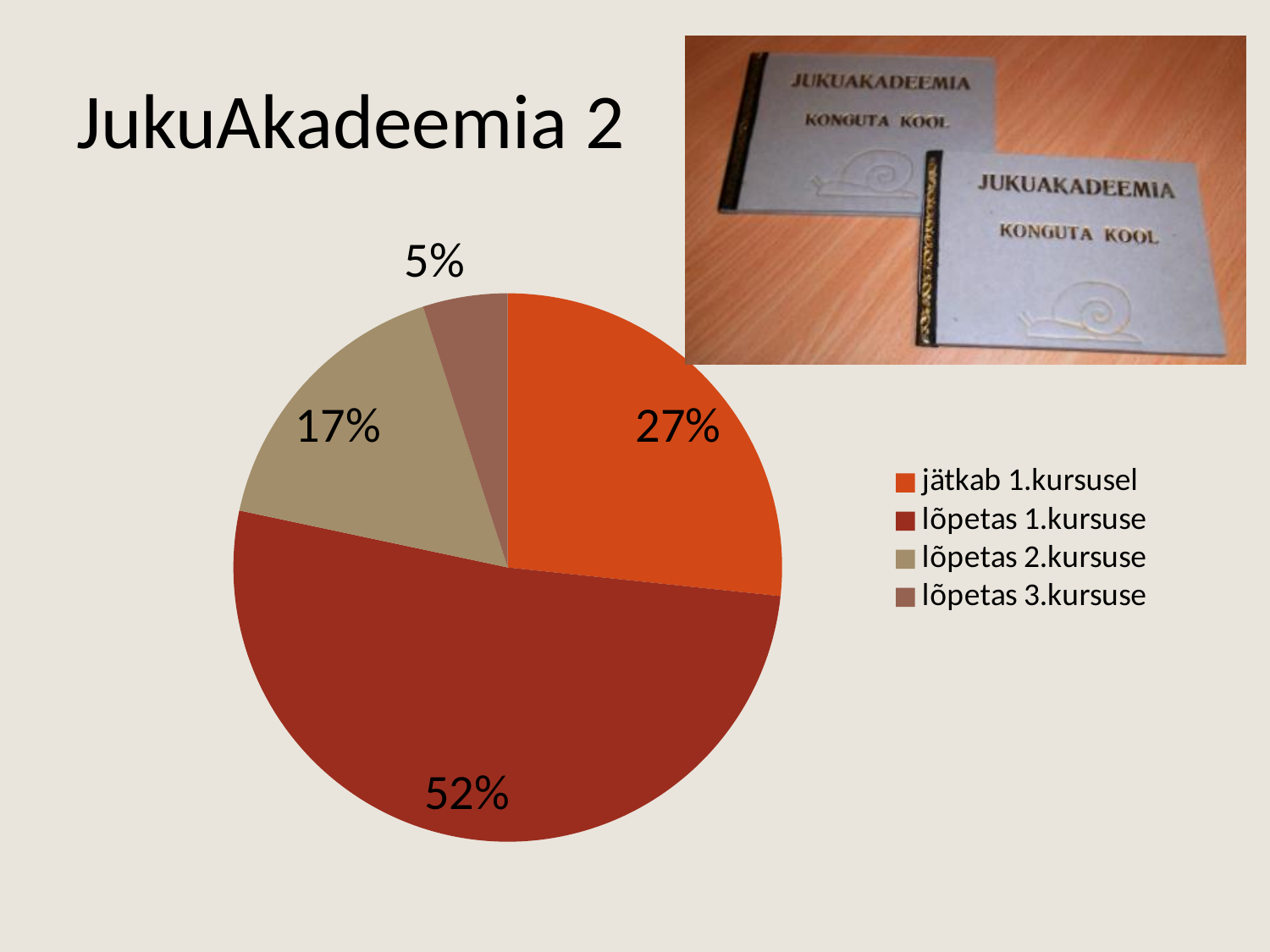
What is the difference in percentage points between "lõpetas 1.kursuse" and "jätkab 1.kursusel"? 25 What share of the pie does "lõpetas 3.kursuse" take? 5% How many categories does the pie chart have? 4 What kind of chart is shown on the slide? pie chart Which category has the largest slice of the pie? lõpetas 1.kursuse What share of the pie does "lõpetas 2.kursuse" take? 17% Which is larger: the share for "jätkab 1.kursusel" or the share for "lõpetas 2.kursuse"? jätkab 1.kursusel What share of the pie does "jätkab 1.kursusel" take? 27% What is the difference in percentage points between "lõpetas 2.kursuse" and "lõpetas 3.kursuse"? 12 What colour is the slice for "lõpetas 2.kursuse"? tan (beige) Which category has the smallest slice of the pie? lõpetas 3.kursuse